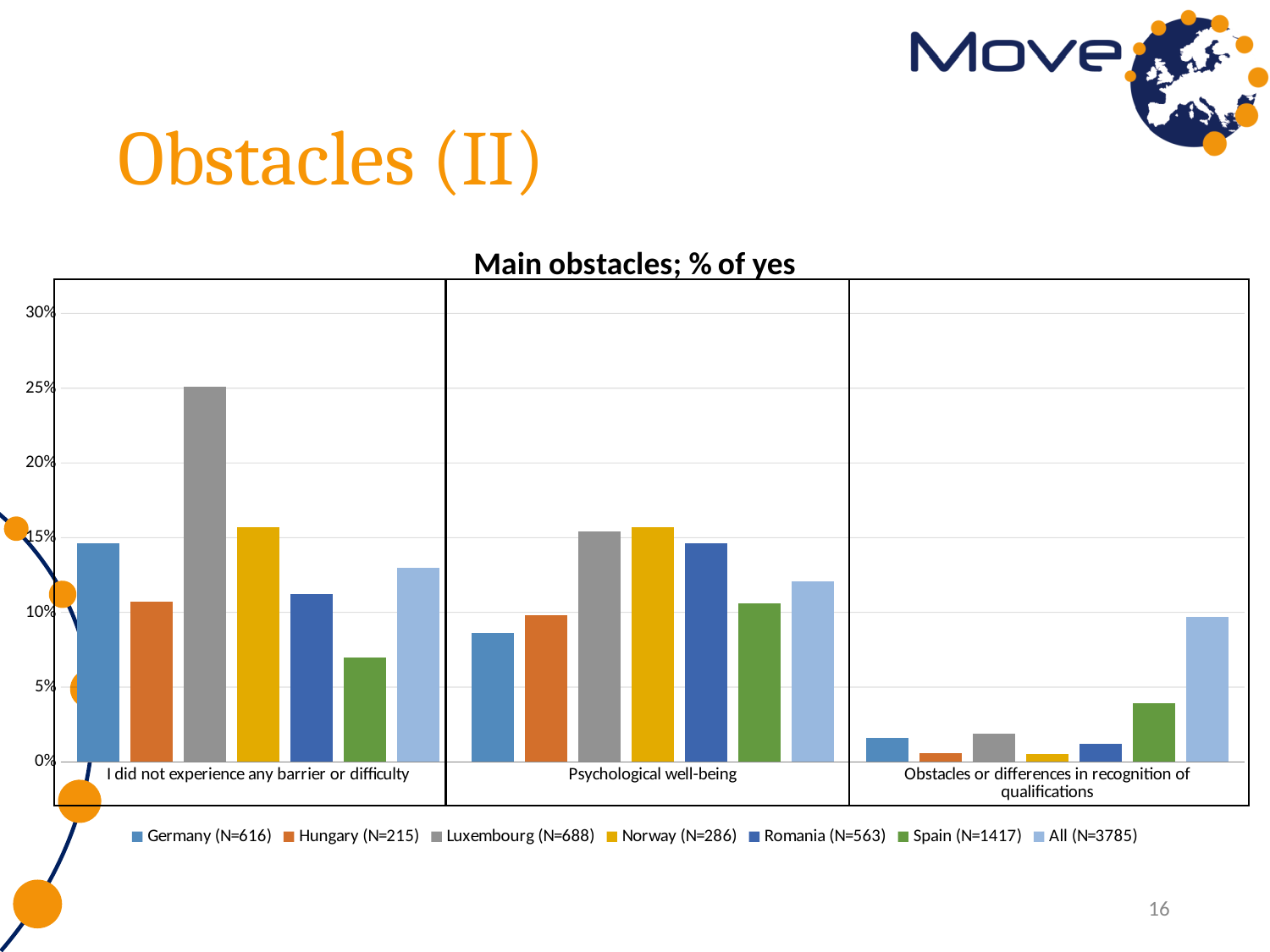
Is the value for Luxembourg under 'I did not experience any barrier or difficulty' greater or less than 20%? greater What is the title of the chart? Main obstacles; % of yes Which series has the lowest value for 'I did not experience any barrier or difficulty'? Spain (N=1417) Is the value for Spain under 'I did not experience any barrier or difficulty' greater or less than 10%? less What kind of chart is shown on the slide? bar chart Under 'I did not experience any barrier or difficulty', which is larger: Germany or Hungary? Germany (N=616) Is the value for Romania under 'Psychological well-being' greater or less than 10%? greater Which country has the highest value for 'I did not experience any barrier or difficulty'? Luxembourg (N=688) Which series has the lowest value for 'Psychological well-being'? Germany (N=616) Which series has the highest value for 'Obstacles or differences in recognition of qualifications'? All (N=3785) How many obstacle categories are shown on the x axis? 3 How many series does the legend list? 7